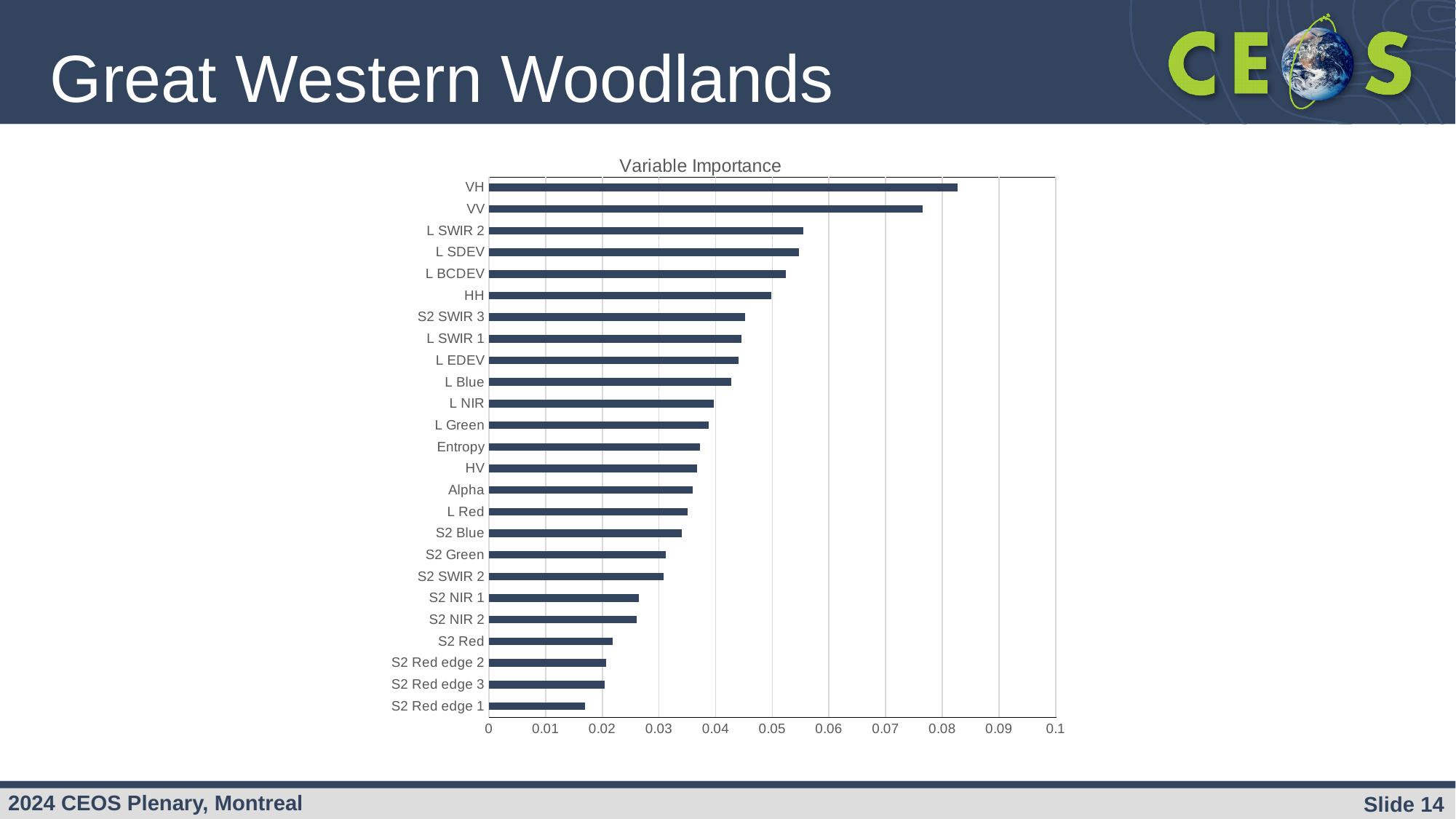
Is the value for VV greater or less than 0.08? less How many variables (categories) are plotted in the chart? 25 Which has the larger value, VH or VV? VH Which variable has the highest importance value? VH Is the value for VH greater or less than 0.08? greater Do the bar values increase or decrease going from the top of the chart to the bottom? decrease Is the value for L SWIR 2 greater or less than 0.05? greater What kind of chart is shown on the slide? bar chart What is the title of the chart? Variable Importance Which variable has the lowest importance value? S2 Red edge 1